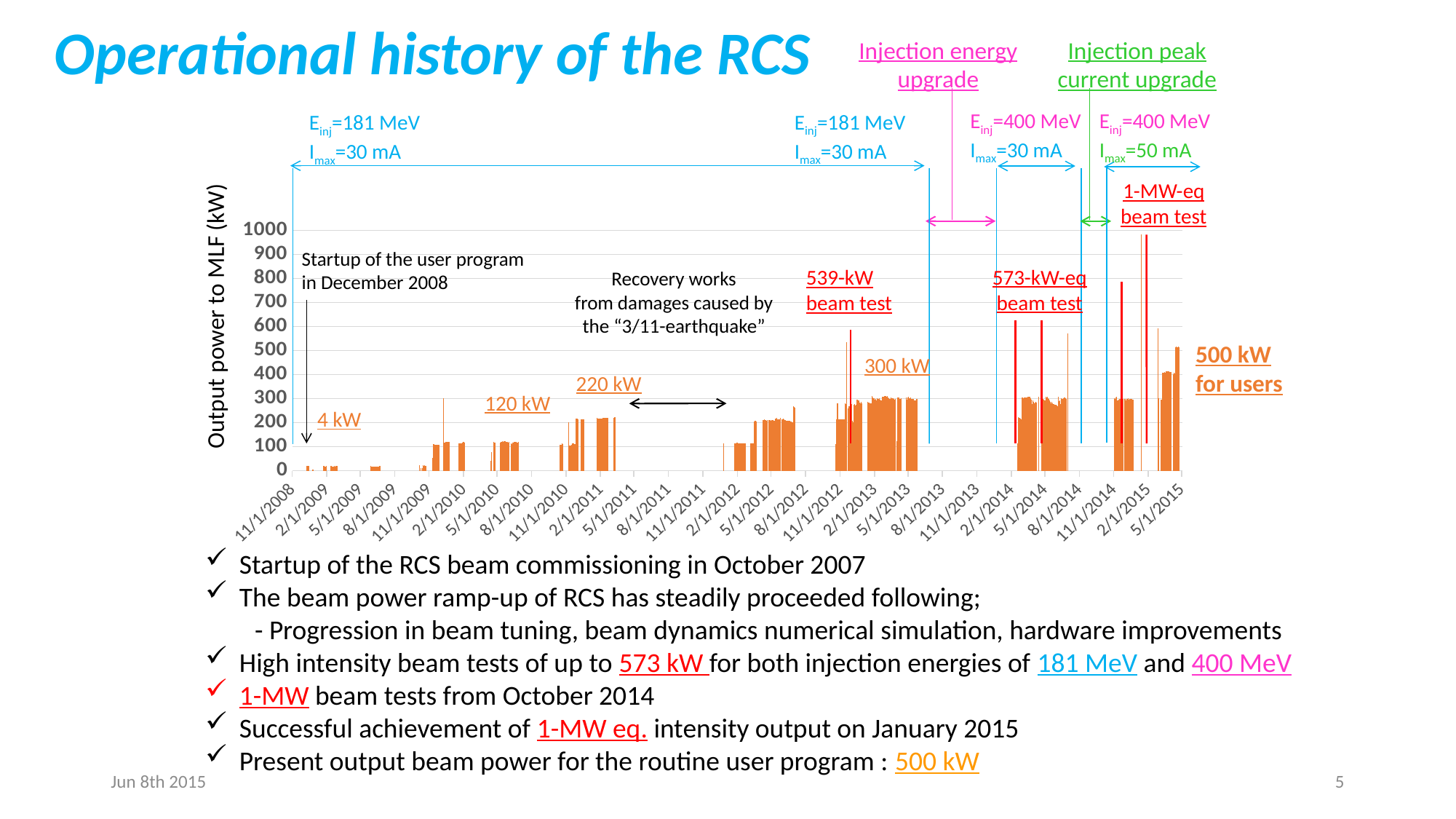
According to the annotation, what output power level was reached in 2013? 300 kW According to the annotation, what output power level was reached in early 2011, before the earthquake recovery works? 220 kW What is the label of the vertical axis of the chart? Output power to MLF (kW) Is the output power to MLF around 5/1/2014 greater or less than 200? greater According to the annotation, what output power level was reached in 2010? 120 kW What is the difference between the annotated 300 kW level of 2013 and the annotated 120 kW level of 2010? 180 kW Overall, does the output power to MLF rise or fall from 2008 to 2015? rise Is the output power to MLF around 2/1/2010 greater or less than 200? less What kind of chart is shown on the slide? bar chart What is the highest tick value shown on the vertical axis? 1000 What is the present output beam power for users shown at the right end of the chart? 500 kW According to the annotation, what was the output power to MLF at the startup of the user program in early 2009? 4 kW